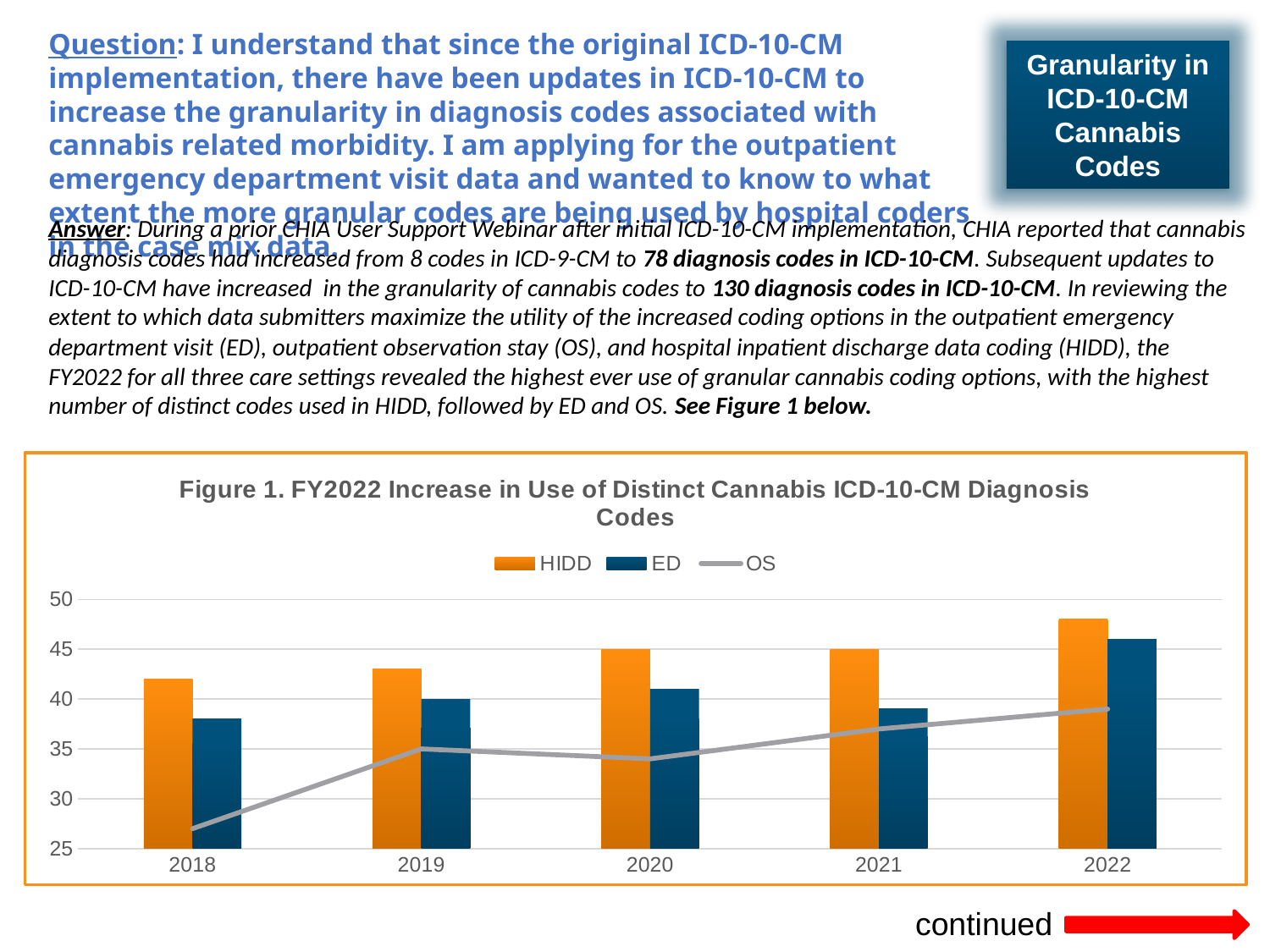
Does the HIDD series rise or fall from 2018 to 2022 in Figure 1? rise Which series in Figure 1 is drawn as a line rather than bars? OS In which year is the OS value lowest in Figure 1? 2018 In which year is the ED value highest in Figure 1? 2022 What kind of chart is Figure 1? bar chart with a line How many series does the legend of Figure 1 list? 3 How many years are shown on the x axis of Figure 1? 5 Is the OS value for 2018 greater or less than 30? less Is the HIDD value for 2022 greater or less than 45? greater In which year is the HIDD value highest in Figure 1? 2022 Is the ED value for 2018 greater or less than 40? less In 2018, which is larger in Figure 1: HIDD or ED? HIDD